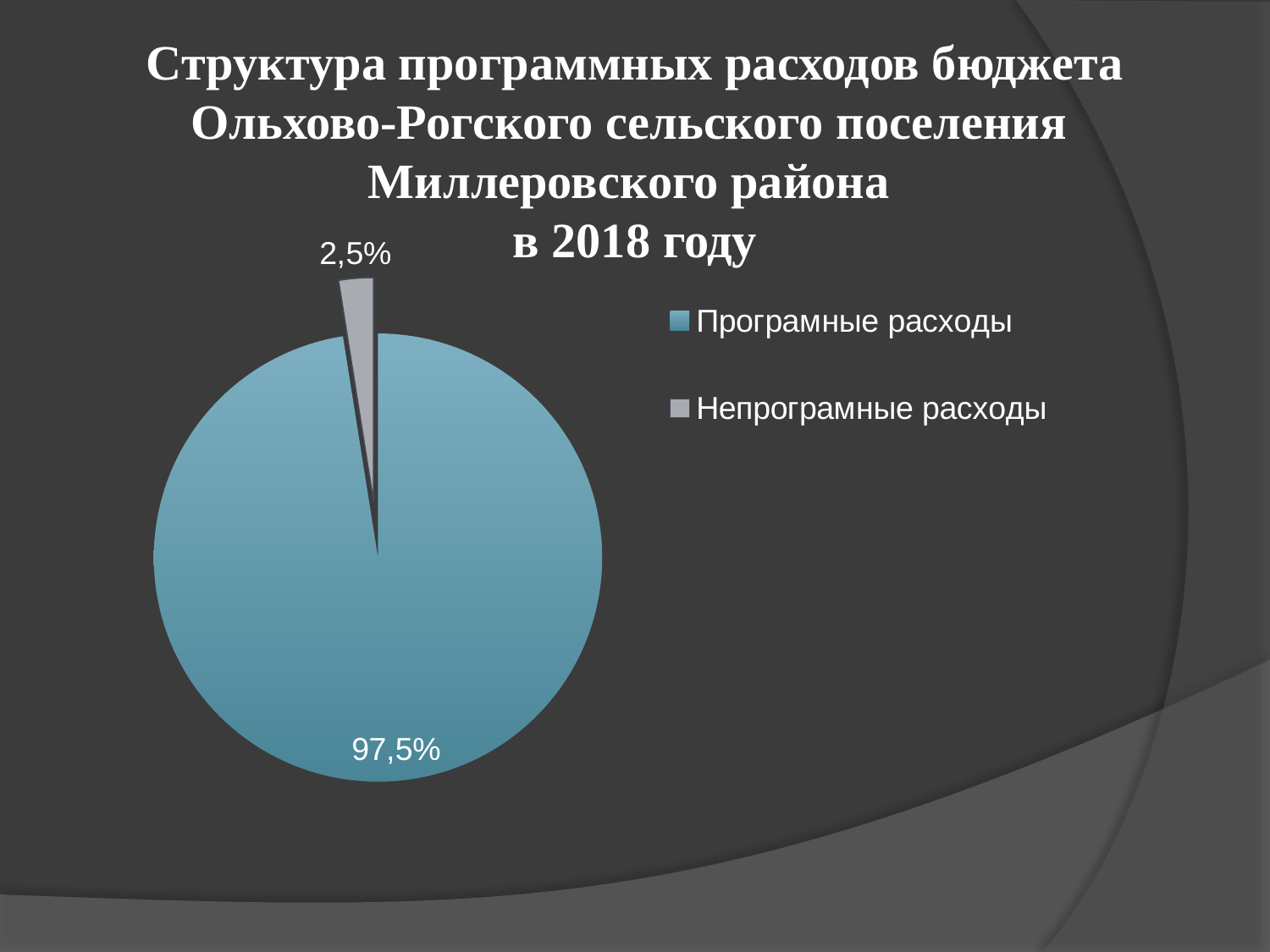
How many entries does the legend list? 2 What is the difference in percentage points between Програмные расходы and Непрограмные расходы? 95 percentage points Which category has the smallest slice of the pie? Непрограмные расходы Which is larger: the slice for Програмные расходы or the slice for Непрограмные расходы? Програмные расходы What colour is the slice for Непрограмные расходы? grey What type of chart is shown on the slide? pie chart Which year does the chart title refer to? 2018 How many slices does the pie chart have? 2 What share of the pie is labelled for Програмные расходы? 97,5% What share of the pie is labelled for Непрограмные расходы? 2,5% Which category has the largest slice of the pie? Програмные расходы